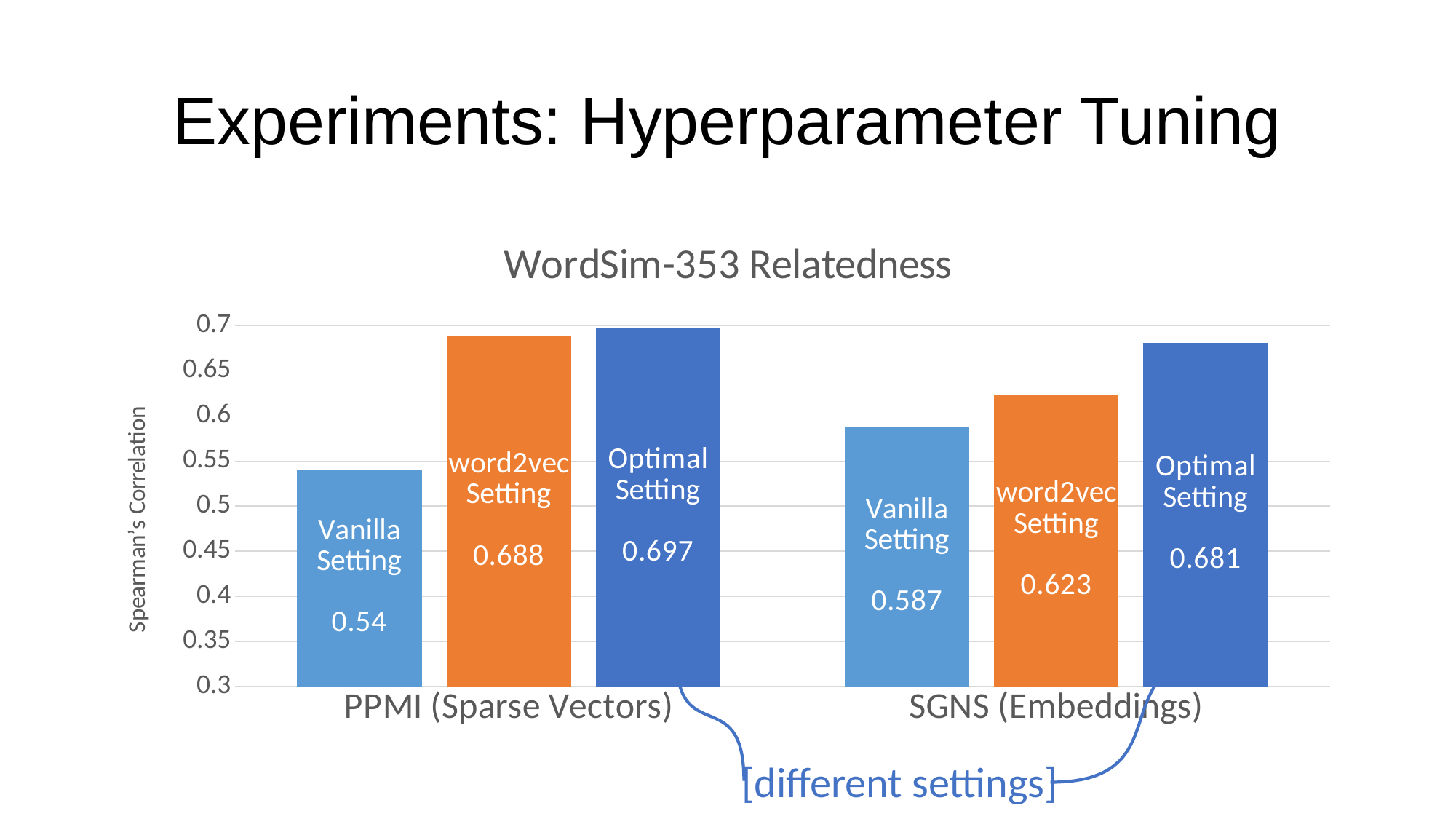
Which bar has the highest value on the chart? Optimal Setting under PPMI (Sparse Vectors) What is the Spearman's Correlation for the Vanilla Setting under PPMI (Sparse Vectors)? 0.54 What is the title of the chart? WordSim-353 Relatedness Is the value for the word2vec Setting under SGNS (Embeddings) greater or less than 0.65? less What is the difference between the word2vec Setting values for PPMI (Sparse Vectors) and SGNS (Embeddings)? 0.065 What is the difference between the Optimal Setting and the Vanilla Setting under PPMI (Sparse Vectors)? 0.157 Which bar has the lowest value on the chart? Vanilla Setting under PPMI (Sparse Vectors) Which is larger: the Vanilla Setting for PPMI (Sparse Vectors) or the Vanilla Setting for SGNS (Embeddings)? SGNS (Embeddings) How many bars are plotted on the chart? 6 What is the value for the word2vec Setting under SGNS (Embeddings)? 0.623 What is the value for the Optimal Setting under SGNS (Embeddings)? 0.681 What type of chart is shown on the slide? bar chart